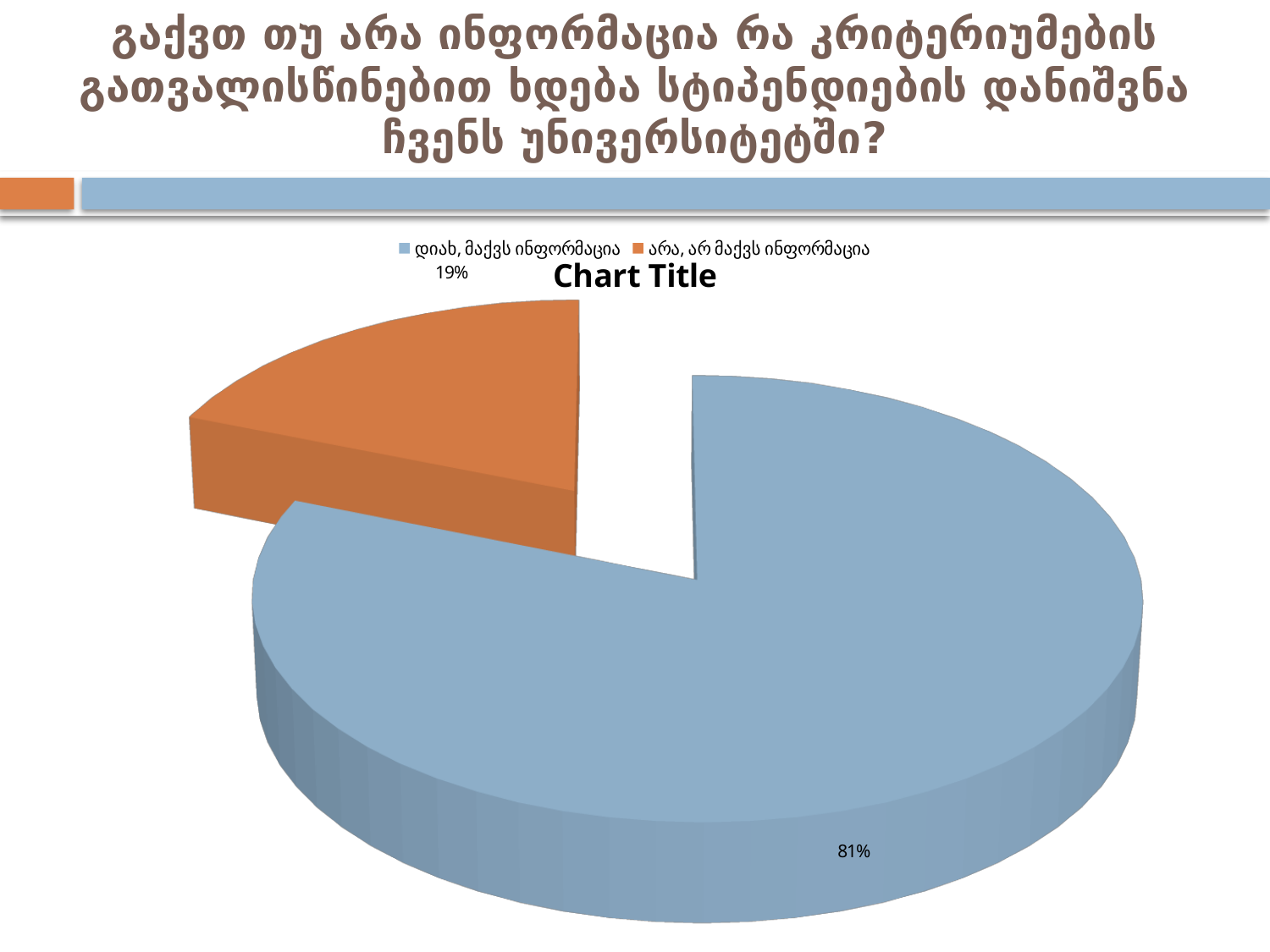
What is the value shown for the blue slice? 81% What is the title printed on the chart itself? Chart Title What share of the pie does the slice "დიახ, მაქვს ინფორმაცია" take? 81% How many entries does the chart legend list? 2 What is the value shown for the orange slice? 19% What share of the pie does the slice "არა, არ მაქვს ინფორმაცია" take? 19% Which is larger: the share for "დიახ, მაქვს ინფორმაცია" or the share for "არა, არ მაქვს ინფორმაცია"? დიახ, მაქვს ინფორმაცია How many slices does the pie chart have? 2 What is the difference in percentage points between the "დიახ, მაქვს ინფორმაცია" slice and the "არა, არ მაქვს ინფორმაცია" slice? 62 What kind of chart is shown on the slide? pie chart Which slice is the smallest in the pie chart? არა, არ მაქვს ინფორმაცია Which slice is the largest in the pie chart? დიახ, მაქვს ინფორმაცია